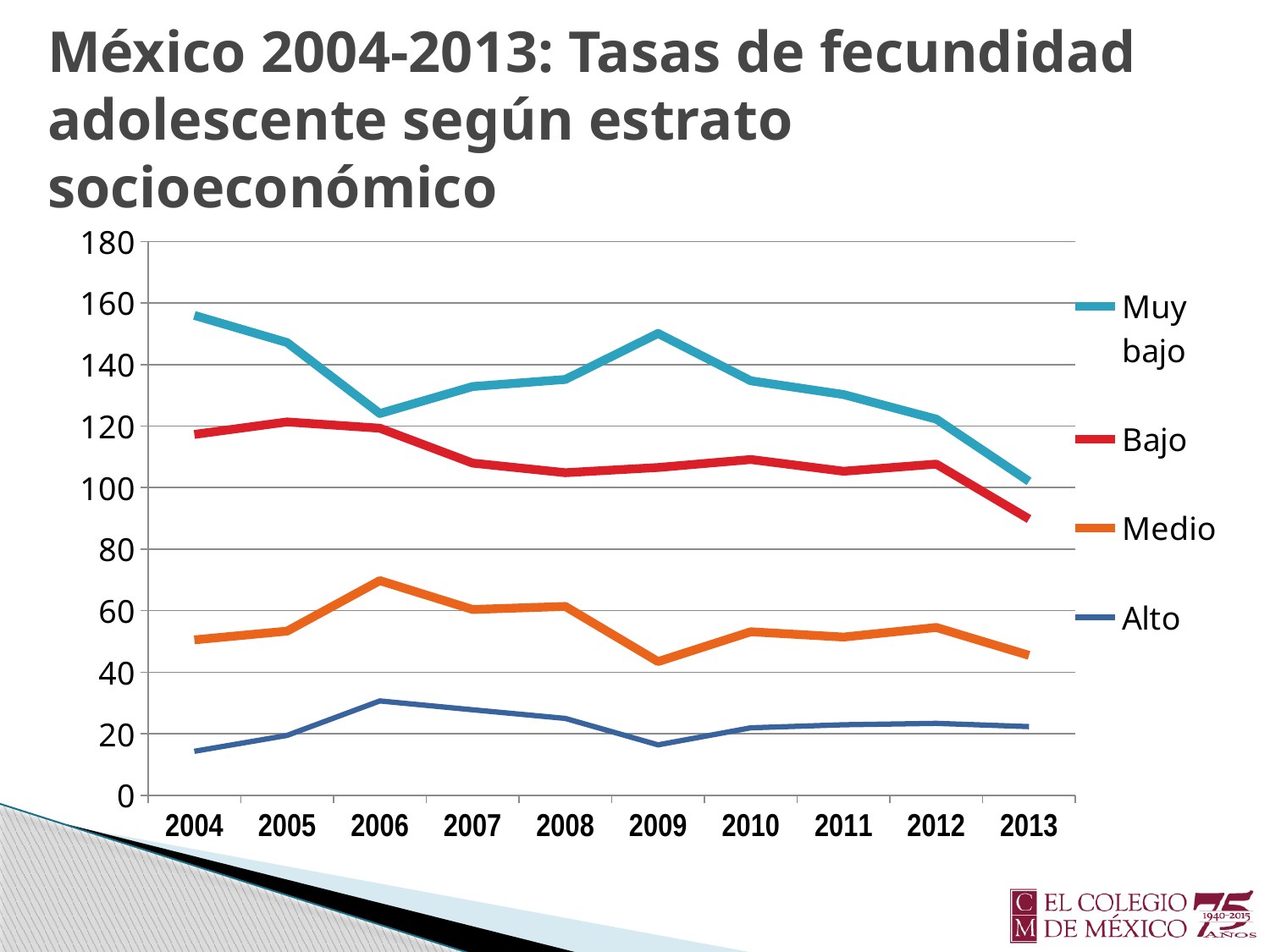
Is the value for Medio in 2006 greater or less than 60? greater How many series does the legend list? 4 For the Muy bajo series, which is larger: the value in 2009 or the value in 2006? 2009 Does the Muy bajo series rise or fall overall from 2004 to 2013? fall How many years are shown along the x axis? 10 Which series has the lowest values across the whole period? Alto Is the value for Muy bajo in 2004 greater or less than 140? greater Is the value for Bajo in 2013 greater or less than 100? less In which year does the Medio series reach its highest value? 2006 What kind of chart is shown on the slide? line chart Which series has the highest values across the whole period? Muy bajo